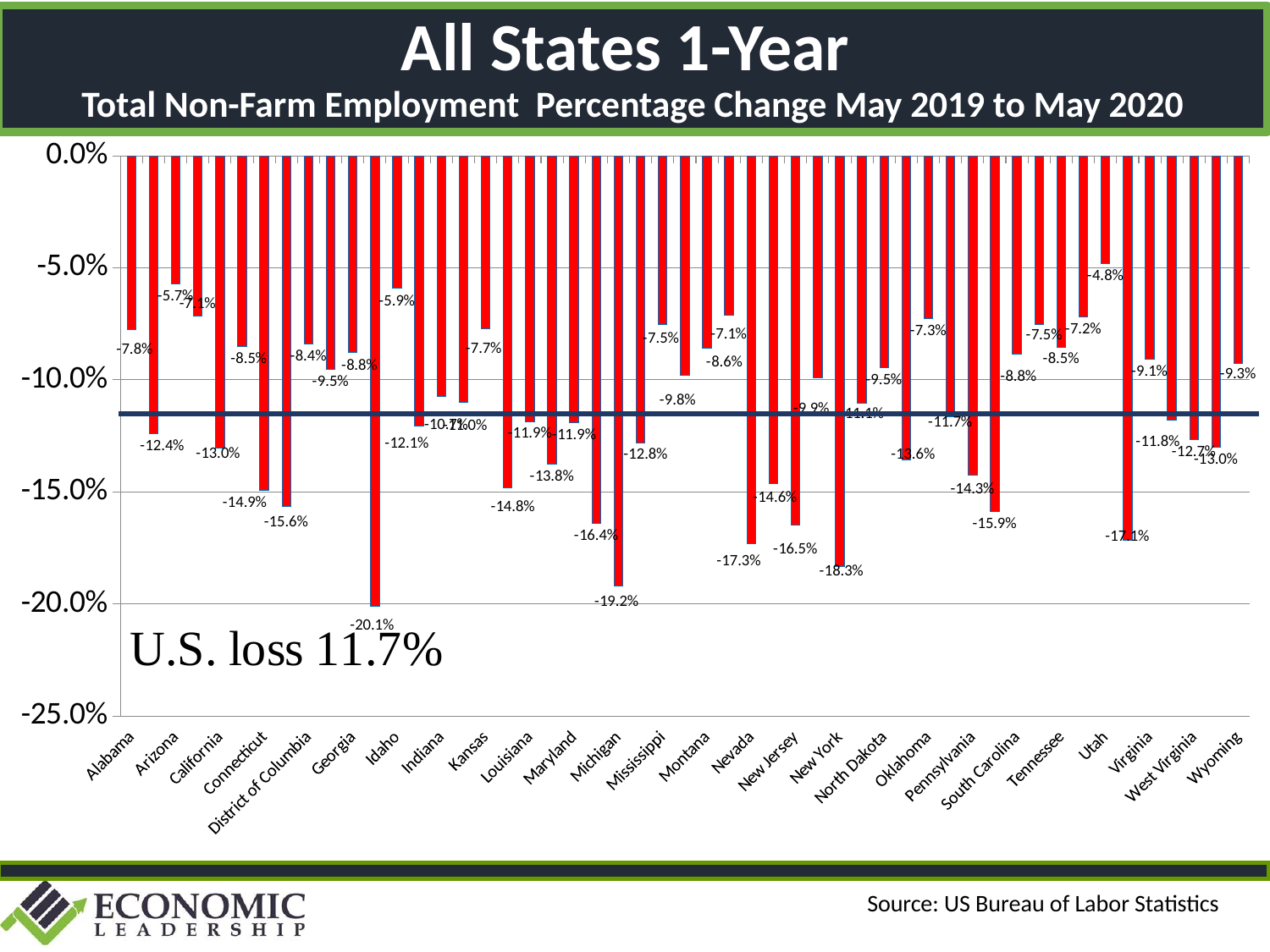
Is the value for Arizona greater or less than -10.0%? greater What is the percentage change shown for Utah? -4.8% What is the percentage change shown for New York? -18.3% What is the percentage change shown for Wyoming? -9.3% What kind of chart is shown on the slide? bar chart Which labelled state has the smallest employment loss on the chart? Utah What is the percentage change shown for Alabama? -7.8% What is the lowest (most negative) value labelled on the chart? -20.1% What is the percentage change shown for Nevada? -17.3% Which has the larger employment loss, Nevada or New York? New York What U.S. loss figure is annotated on the chart? 11.7% What is the difference between the values for Alabama and Wyoming? 1.5%